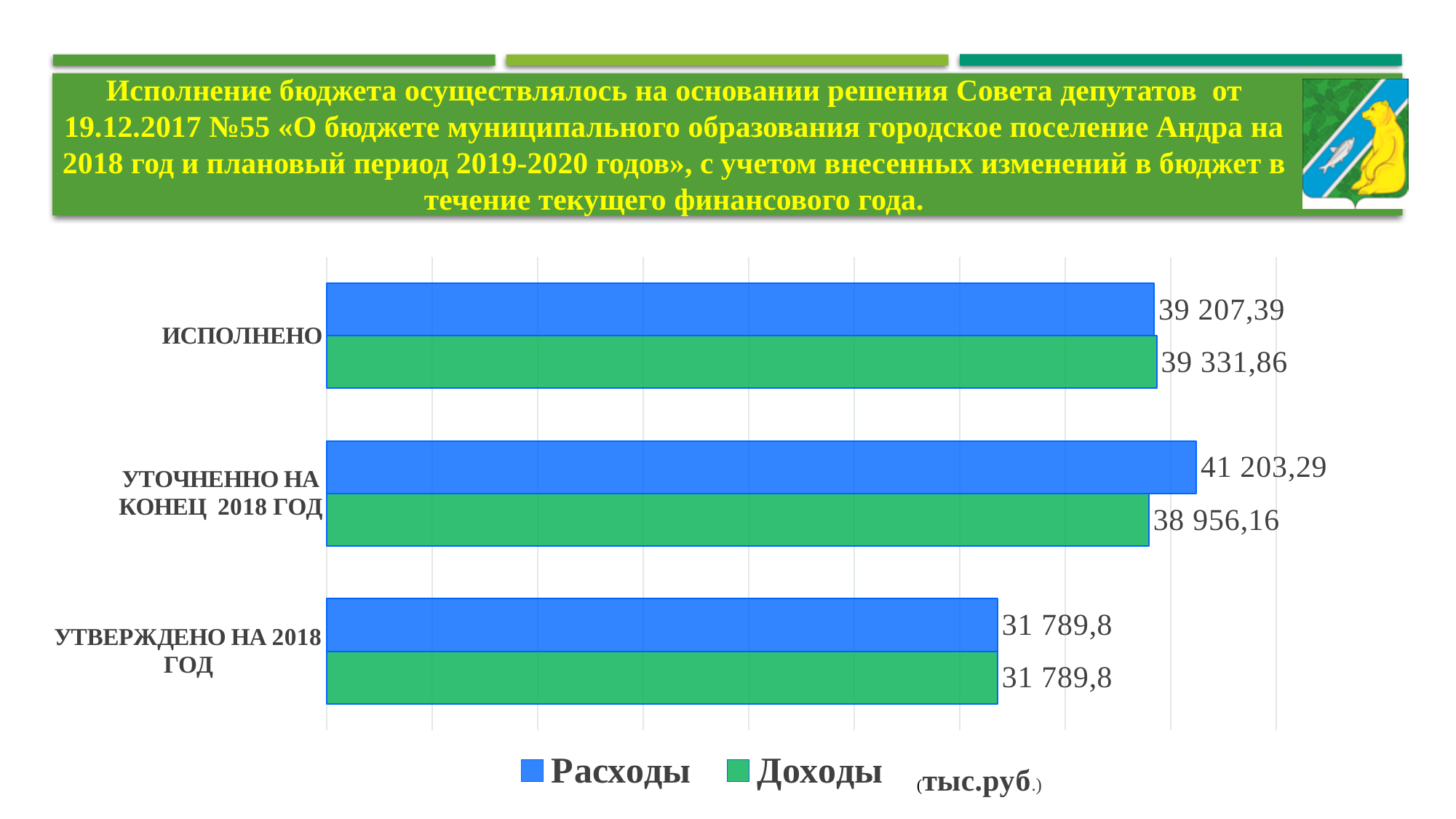
What is the value of Доходы for УТВЕРЖДЕНО НА 2018 ГОД? 31 789,8 What is the value of Расходы for ИСПОЛНЕНО? 39 207,39 What is the difference between Доходы and Расходы for ИСПОЛНЕНО? 124,47 What is the value of Доходы for ИСПОЛНЕНО? 39 331,86 What is the difference between Расходы and Доходы for УТОЧНЕННО НА КОНЕЦ 2018 ГОД? 2 247,13 What kind of chart is shown on the slide? Bar chart What is the value of Расходы for УТОЧНЕННО НА КОНЕЦ 2018 ГОД? 41 203,29 How many categories are shown on the chart? 3 For УТОЧНЕННО НА КОНЕЦ 2018 ГОД, which is larger: Расходы or Доходы? Расходы How many series does the legend list? 2 Which category has the highest value for Расходы? УТОЧНЕННО НА КОНЕЦ 2018 ГОД Which category has the lowest value for Доходы? УТВЕРЖДЕНО НА 2018 ГОД